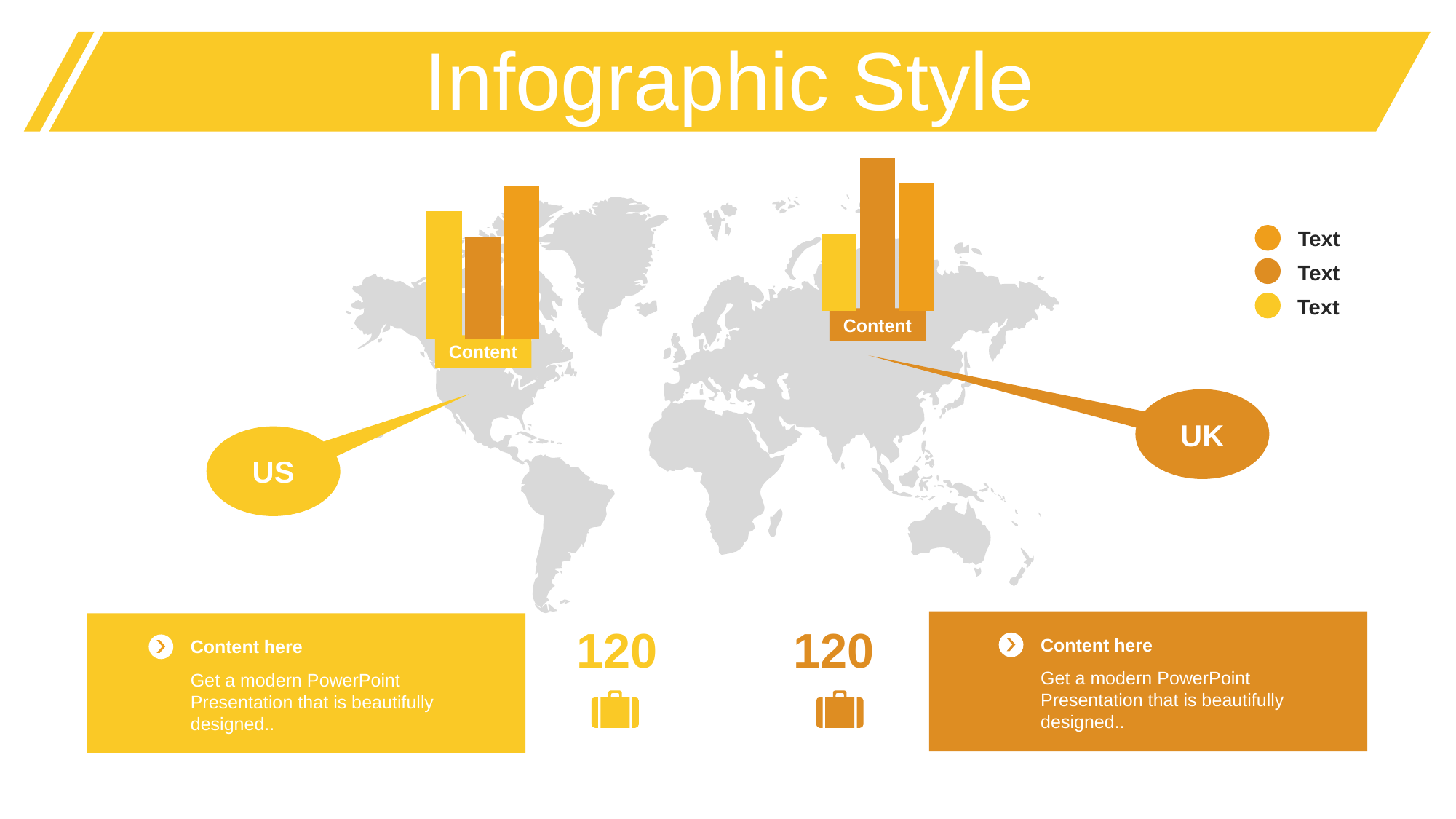
How many entries does the legend on the right list? 3 What label appears beneath the bars of each chart? Content In the US chart, which bar is the tallest? the light orange (right) bar What kind of chart is shown over Europe/Asia on the map (the UK chart)? bar chart In the UK chart, is the yellow bar or the dark orange bar taller? the dark orange bar In the UK chart, which bar is the shortest? the yellow (left) bar In the US chart, which bar is the shortest? the dark orange (middle) bar What text is used for each of the three legend entries? Text In the UK chart, which bar is the tallest? the dark orange (middle) bar What kind of chart is shown over North America on the map (the US chart)? bar chart How many bars does the US chart have? 3 How many bars does the UK chart have? 3